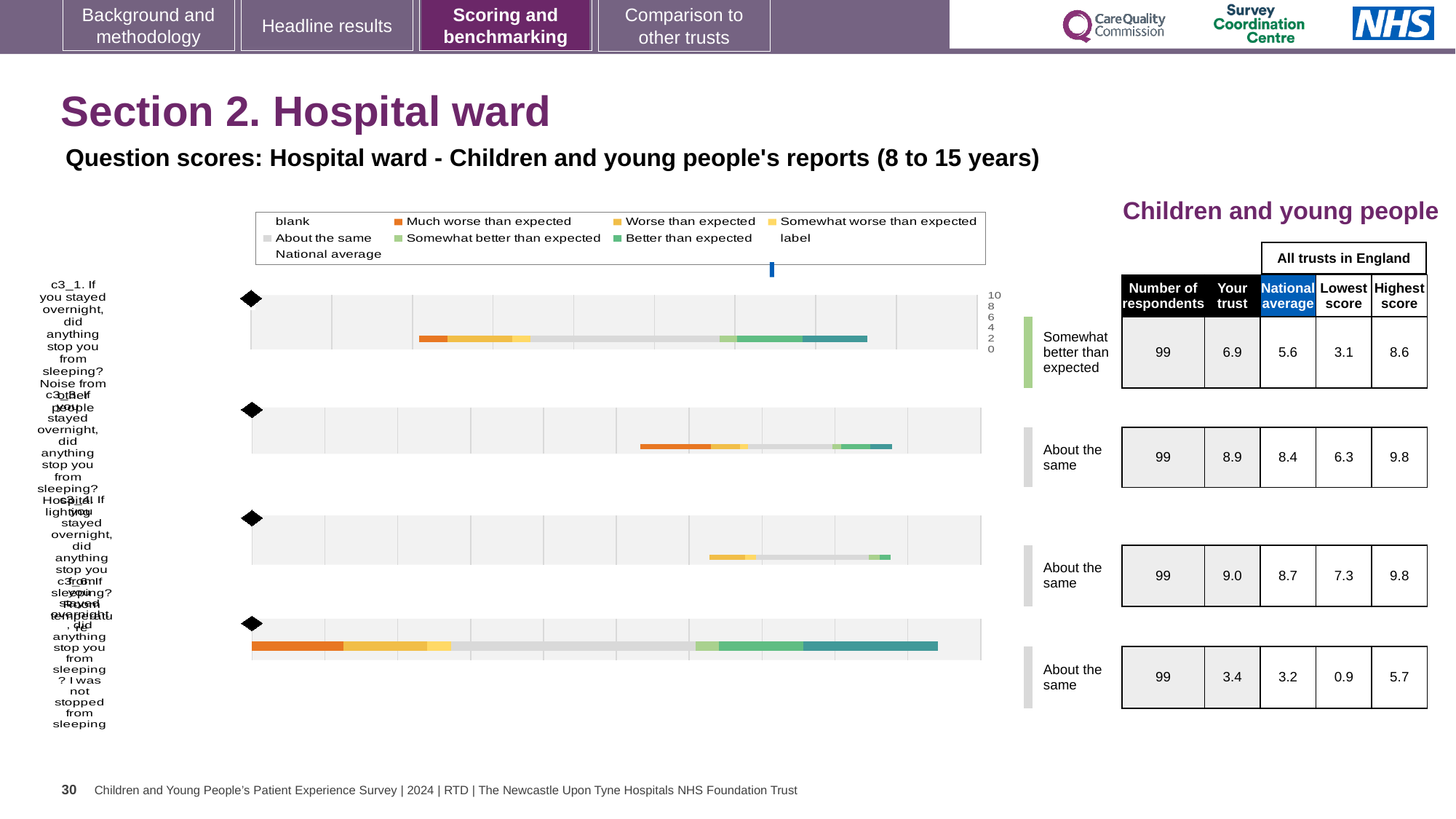
Which legend entry is shown in grey? About the same What kind of chart is shown on the slide? bar chart Which legend entry is shown in orange? Much worse than expected Which of the four stacked bars is the shortest? the third bar Which of the four stacked bars is the longest? the bottom (fourth) bar What is the highest tick value shown on the chart's axis? 10 How many stacked bars are plotted in the chart? 4 How many entries does the chart's legend list? 9 What is the lowest tick value shown on the chart's axis? 0